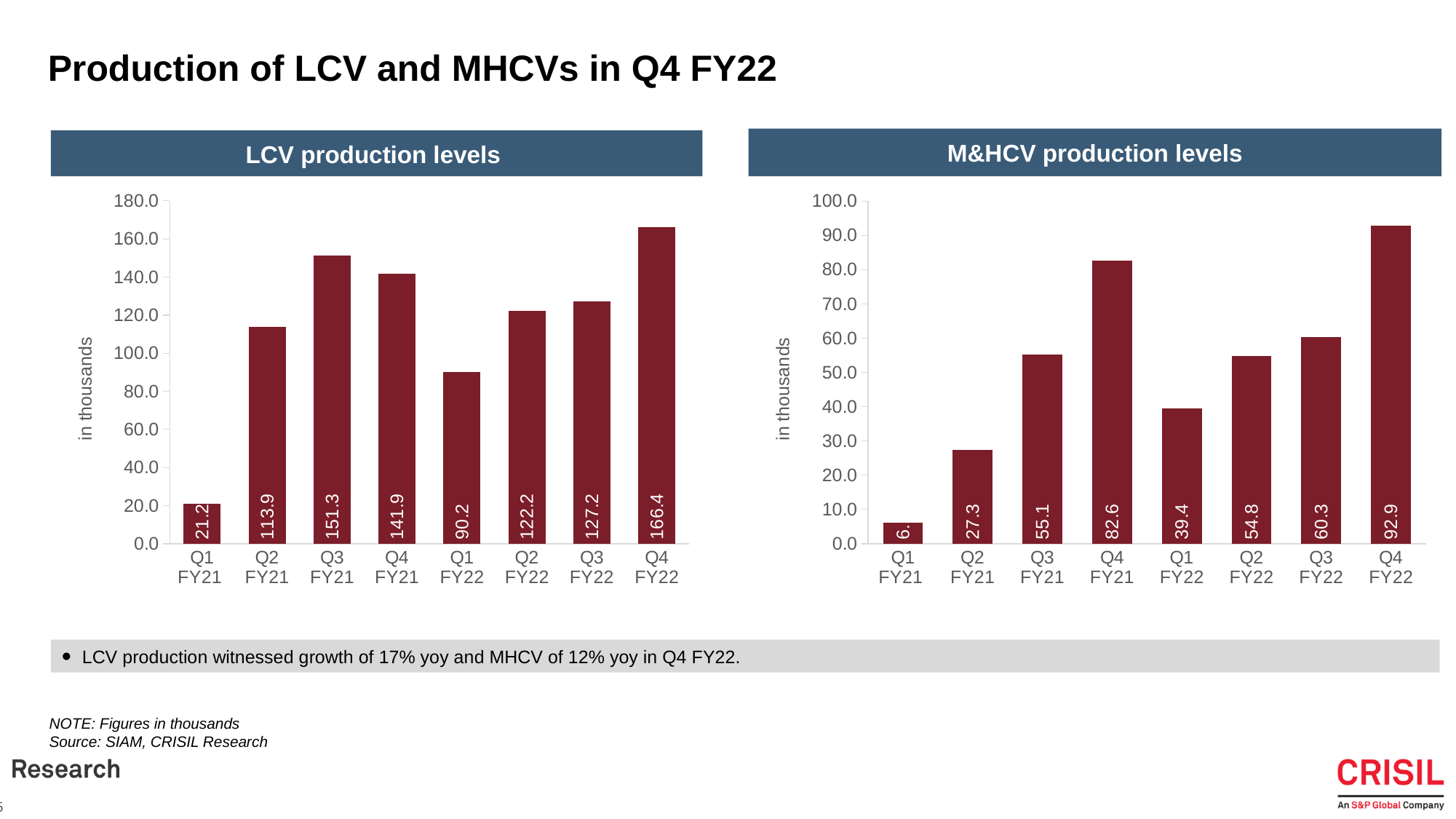
What is the y-axis label on the LCV production levels chart? in thousands In the M&HCV production levels chart, which quarter has the lowest value? Q1 FY21 In the LCV production levels chart, what is the difference between Q4 FY22 and Q4 FY21? 24.5 In the LCV production levels chart, which quarter has the highest value? Q4 FY22 In the LCV production levels chart, is the value for Q1 FY22 greater or less than 100.0? less In the M&HCV production levels chart, which is larger, Q3 FY21 or Q2 FY22? Q3 FY21 In the M&HCV production levels chart, what is the value for Q4 FY21? 82.6 How many quarters are shown in the M&HCV production levels chart? 8 What kind of chart is the LCV production levels chart? bar chart In the LCV production levels chart, what is the value for Q4 FY22? 166.4 In the M&HCV production levels chart, do the values rise or fall from Q1 FY22 to Q4 FY22? rise In the M&HCV production levels chart, what is the difference between Q4 FY22 and Q3 FY22? 32.6